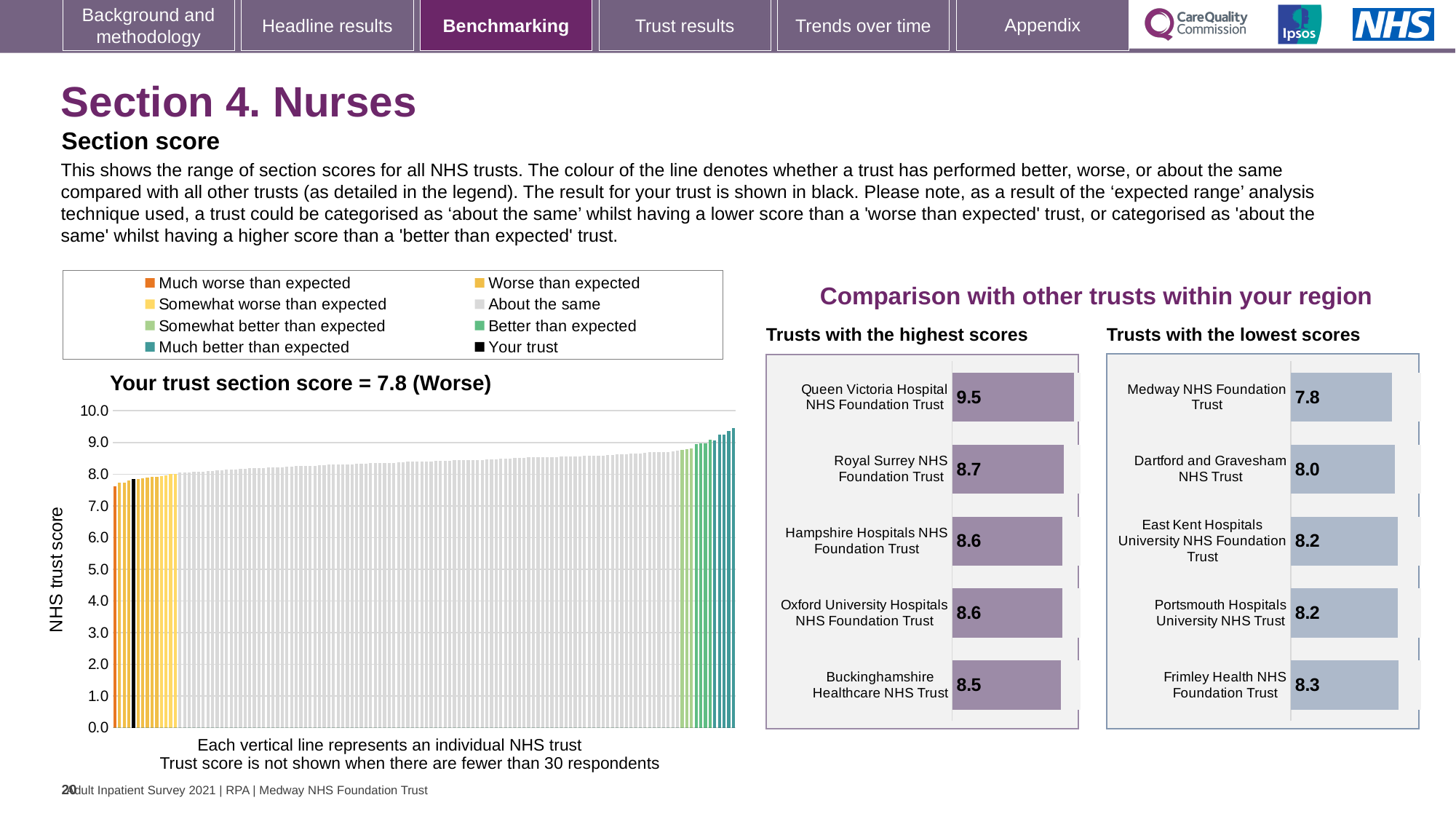
In the 'Trusts with the lowest scores' chart, what is the score for Frimley Health NHS Foundation Trust? 8.3 In the 'Trusts with the lowest scores' chart, what is the difference between the scores of Frimley Health NHS Foundation Trust and Medway NHS Foundation Trust? 0.5 According to the title of the left-hand chart, what is your trust's section score? 7.8 (Worse) How many trusts are shown in the 'Trusts with the highest scores' chart? 5 What kind of chart is the 'Trusts with the lowest scores' chart? Bar chart In the 'Trusts with the lowest scores' chart, which trust has the lowest score? Medway NHS Foundation Trust In the 'Trusts with the highest scores' chart, what is the score for Queen Victoria Hospital NHS Foundation Trust? 9.5 In the 'Trusts with the highest scores' chart, which has the higher score: Royal Surrey NHS Foundation Trust or Buckinghamshire Healthcare NHS Trust? Royal Surrey NHS Foundation Trust In the 'Trusts with the highest scores' chart, what is the difference between the scores of Queen Victoria Hospital NHS Foundation Trust and Royal Surrey NHS Foundation Trust? 0.8 In the 'Trusts with the highest scores' chart, which trust has the highest score? Queen Victoria Hospital NHS Foundation Trust In the 'Trusts with the lowest scores' chart, what is the score for Dartford and Gravesham NHS Trust? 8.0 How many entries does the legend above the left-hand chart list? 8